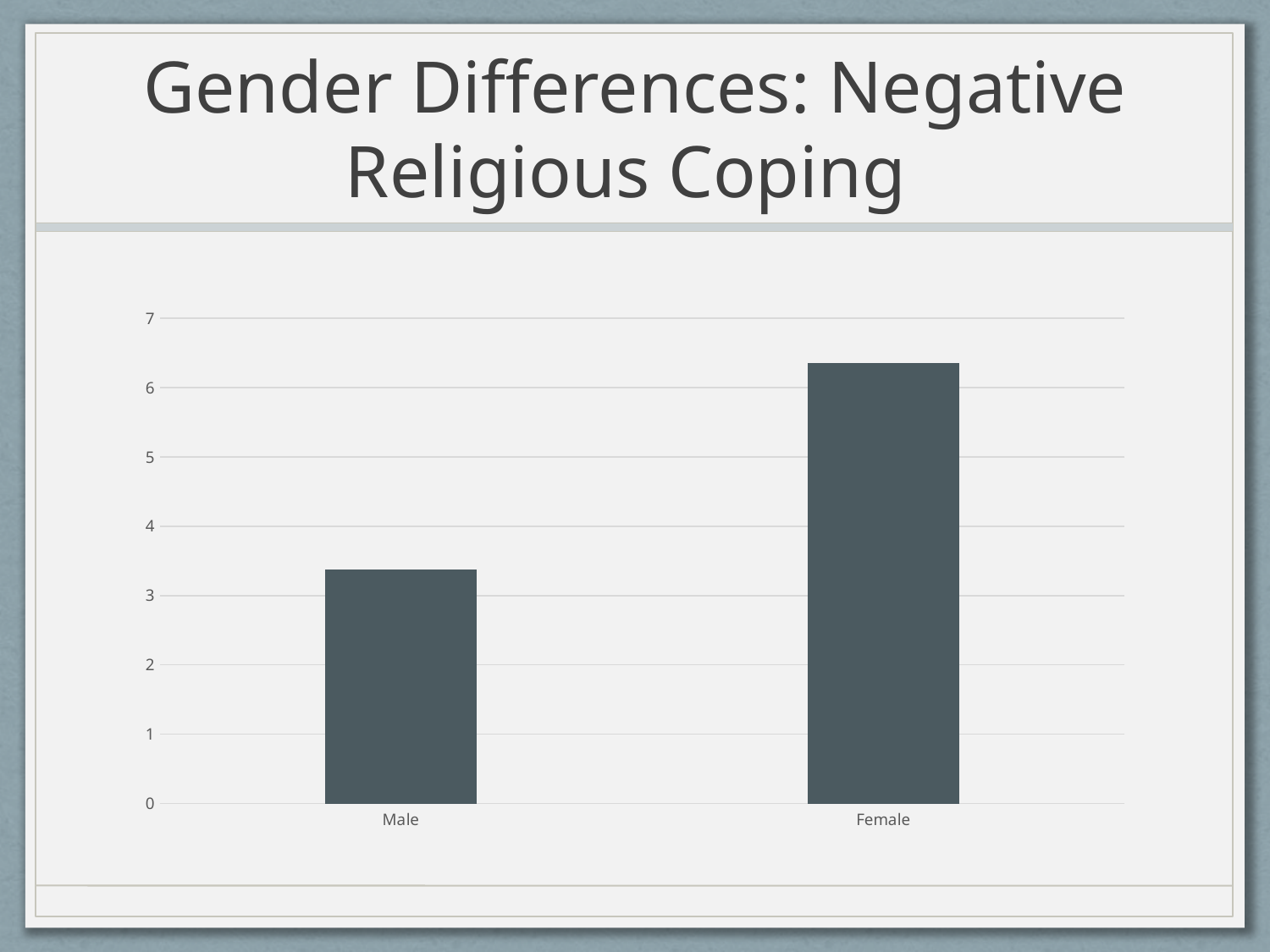
Is the value for Male greater or less than 4? less Do the values rise or fall from Male to Female along the x axis? rise What is the highest value labelled on the vertical axis? 7 Which category has the highest value? Female Which category has the lowest value? Male Is the value for Female greater or less than 6? greater Is the value for Female greater or less than 7? less What kind of chart is shown on the slide? bar chart Which is larger, the value for Male or the value for Female? Female What is the title of the slide containing the chart? Gender Differences: Negative Religious Coping How many categories are shown on the x axis? 2